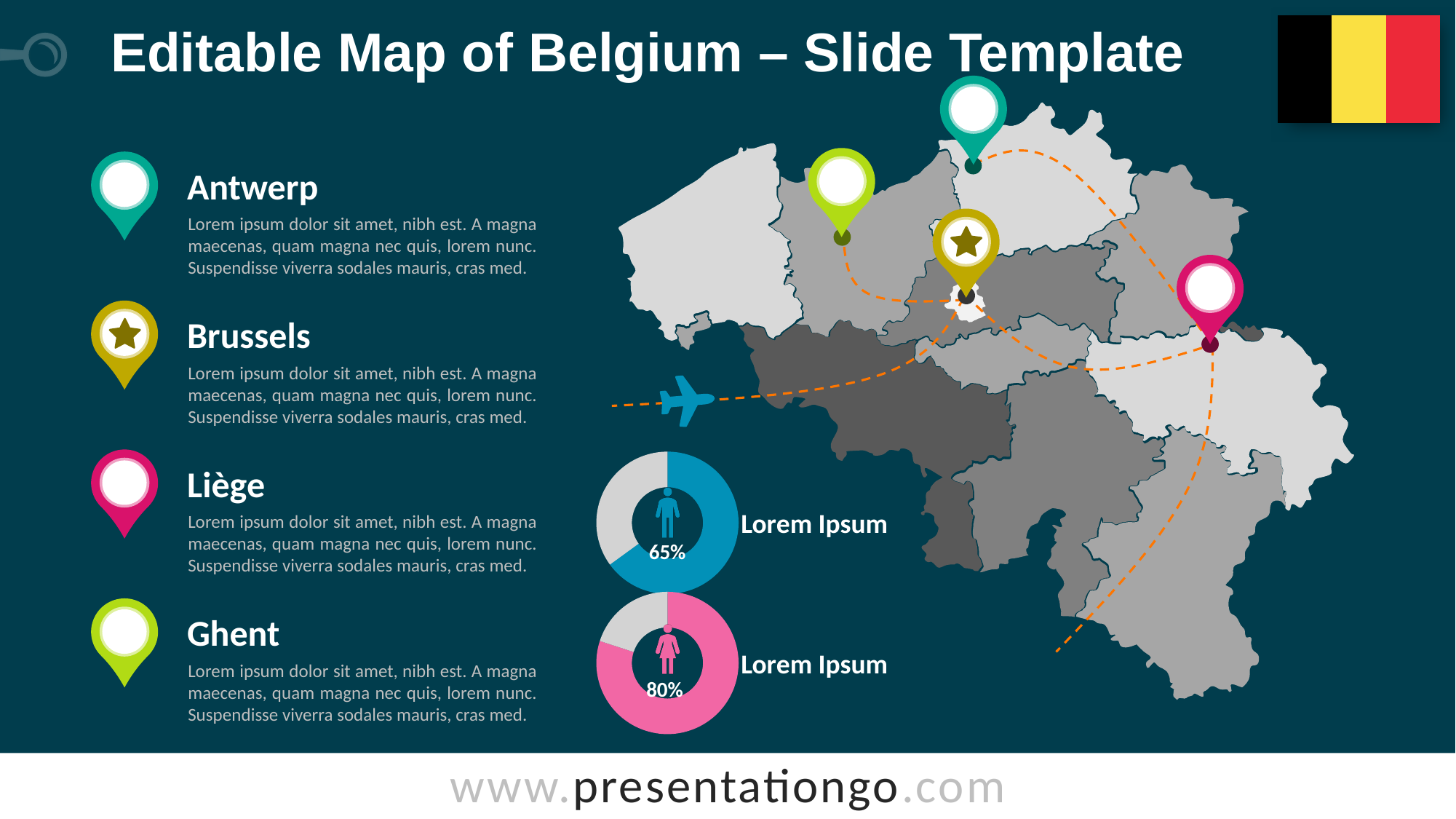
What percentage is shown in the bottom donut chart (the pink one with the female icon)? 80% How many donut charts are on the slide? 2 What colour is the filled portion of the bottom donut chart showing 80%? pink In the bottom pink donut chart, what share of the ring is left unfilled (grey)? 20% Is the value in the bottom pink donut chart greater or less than 75%? greater Is the value in the top blue donut chart greater or less than 50%? greater Which donut chart shows the larger value, the top blue one or the bottom pink one? the bottom pink one (80%) What kind of chart is used to display the 65% and 80% values on the slide? donut chart In the top blue donut chart, what share of the ring is left unfilled (grey)? 35% What text label appears to the right of each donut chart? Lorem Ipsum What percentage is shown in the top donut chart (the blue one with the male icon)? 65% What is the difference between the value in the bottom pink donut chart and the value in the top blue donut chart? 15 percentage points